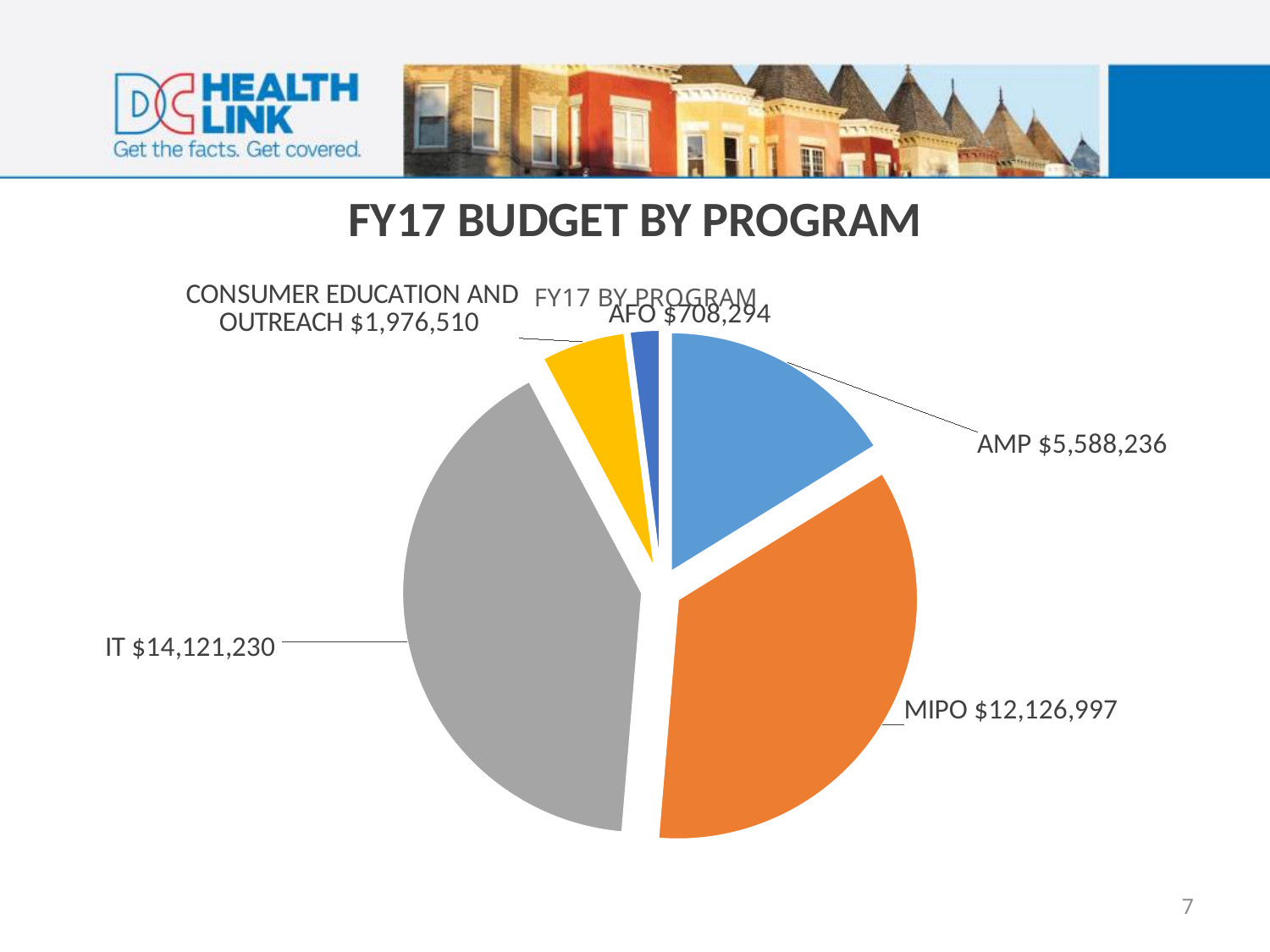
Which program has the largest FY17 budget? IT What colour is the IT slice of the pie chart? Gray What is the FY17 budget for AMP? $5,588,236 Which program has the smallest FY17 budget? AFO Which has a larger FY17 budget, MIPO or AMP? MIPO What is the FY17 budget for Consumer Education and Outreach? $1,976,510 What type of chart is shown on the slide? Pie chart What is the FY17 budget for AFO? $708,294 What is the difference between the IT budget and the MIPO budget? $1,994,233 How many programs are shown in the pie chart? 5 What is the FY17 budget for IT? $14,121,230 What is the FY17 budget for MIPO? $12,126,997